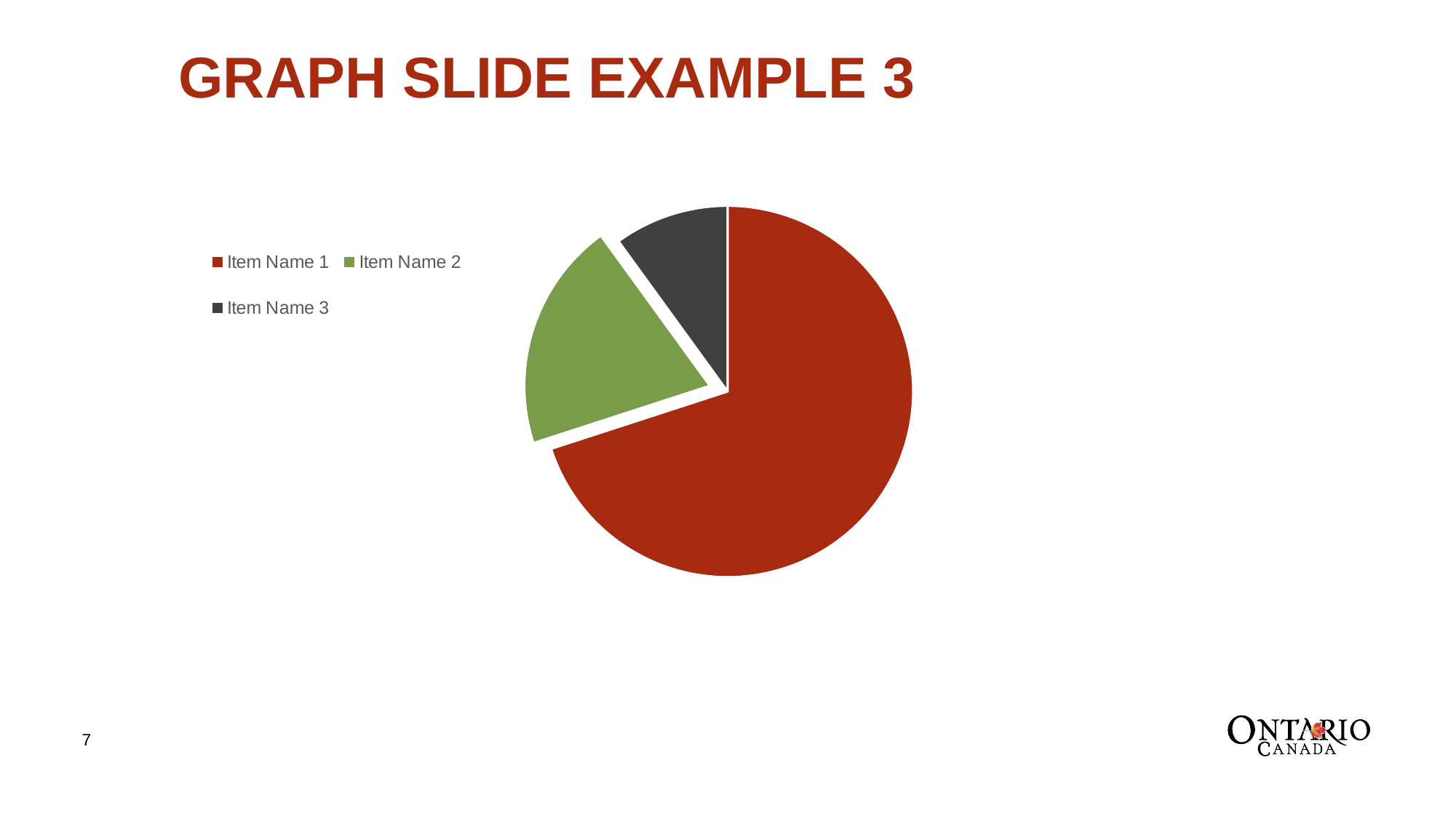
What kind of chart is shown on the slide? pie chart Does Item Name 1 take up more or less than half of the pie chart? more Which item has the largest slice of the pie chart? Item Name 1 What colour is the slice for Item Name 3 in the pie chart? dark grey How many entries does the legend of the pie chart list? 3 How many slices does the pie chart have? 3 What colour is the slice for Item Name 2 in the pie chart? green Which slice is larger, Item Name 2 or Item Name 3? Item Name 2 Which slice is larger, Item Name 1 or Item Name 2? Item Name 1 Which item has the smallest slice of the pie chart? Item Name 3